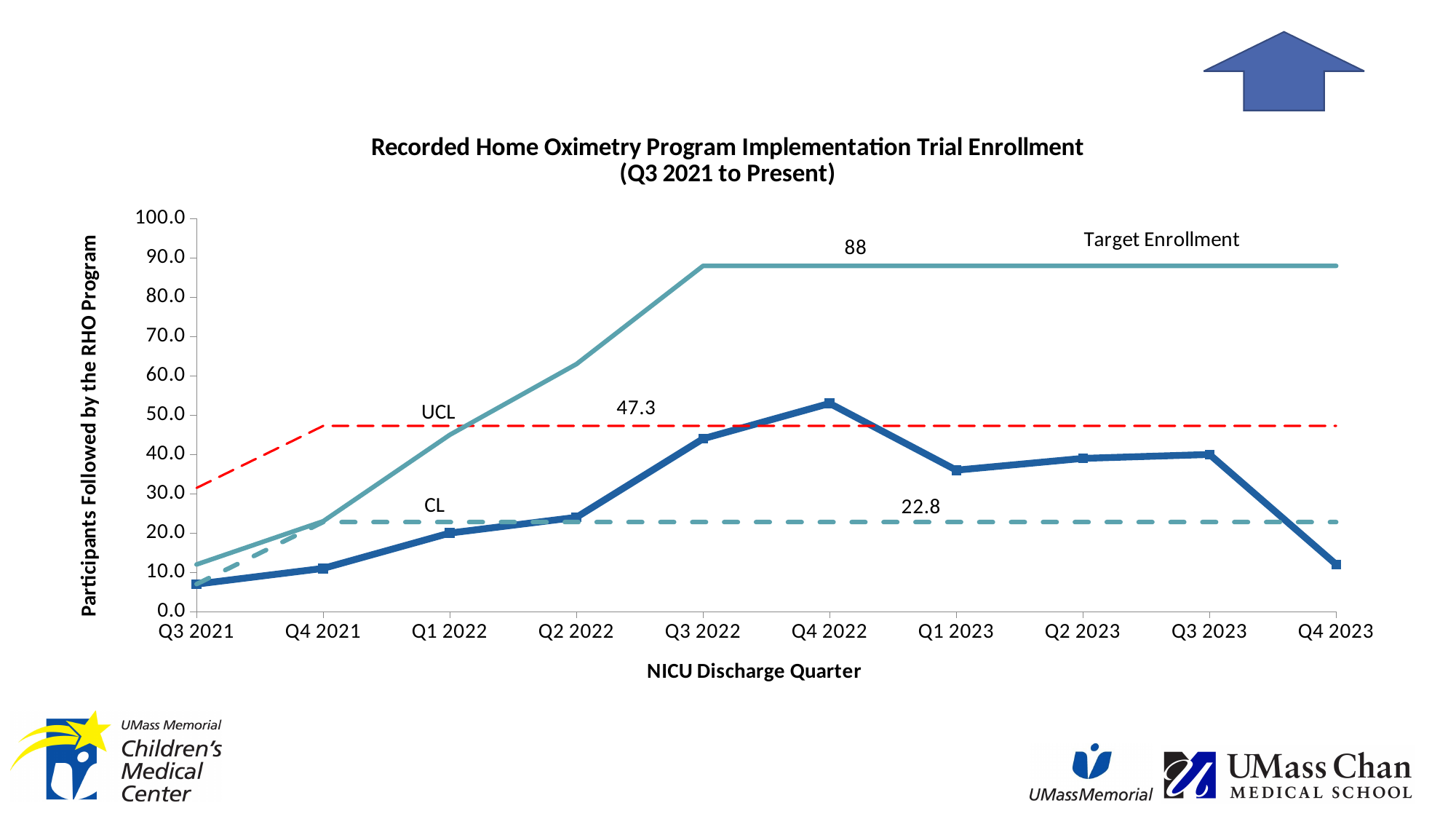
What is the title of the x axis? NICU Discharge Quarter Is the value of the participants line for Q1 2023 greater or less than 40? less In which quarter does the participants line have its lowest value? Q3 2021 What is the value of the Target Enrollment line as labelled on the chart? 88 Which quarter has a higher value on the participants line, Q3 2022 or Q1 2023? Q3 2022 How many NICU discharge quarters are shown on the x axis? 10 What is the difference between the UCL value and the CL value? 24.5 What kind of chart is shown on the slide? Line chart What is the value of the CL line as labelled on the chart? 22.8 Is the value of the participants line for Q4 2022 greater or less than 50? greater What is the value of the UCL line as labelled on the chart? 47.3 In which quarter does the participants line reach its highest value? Q4 2022